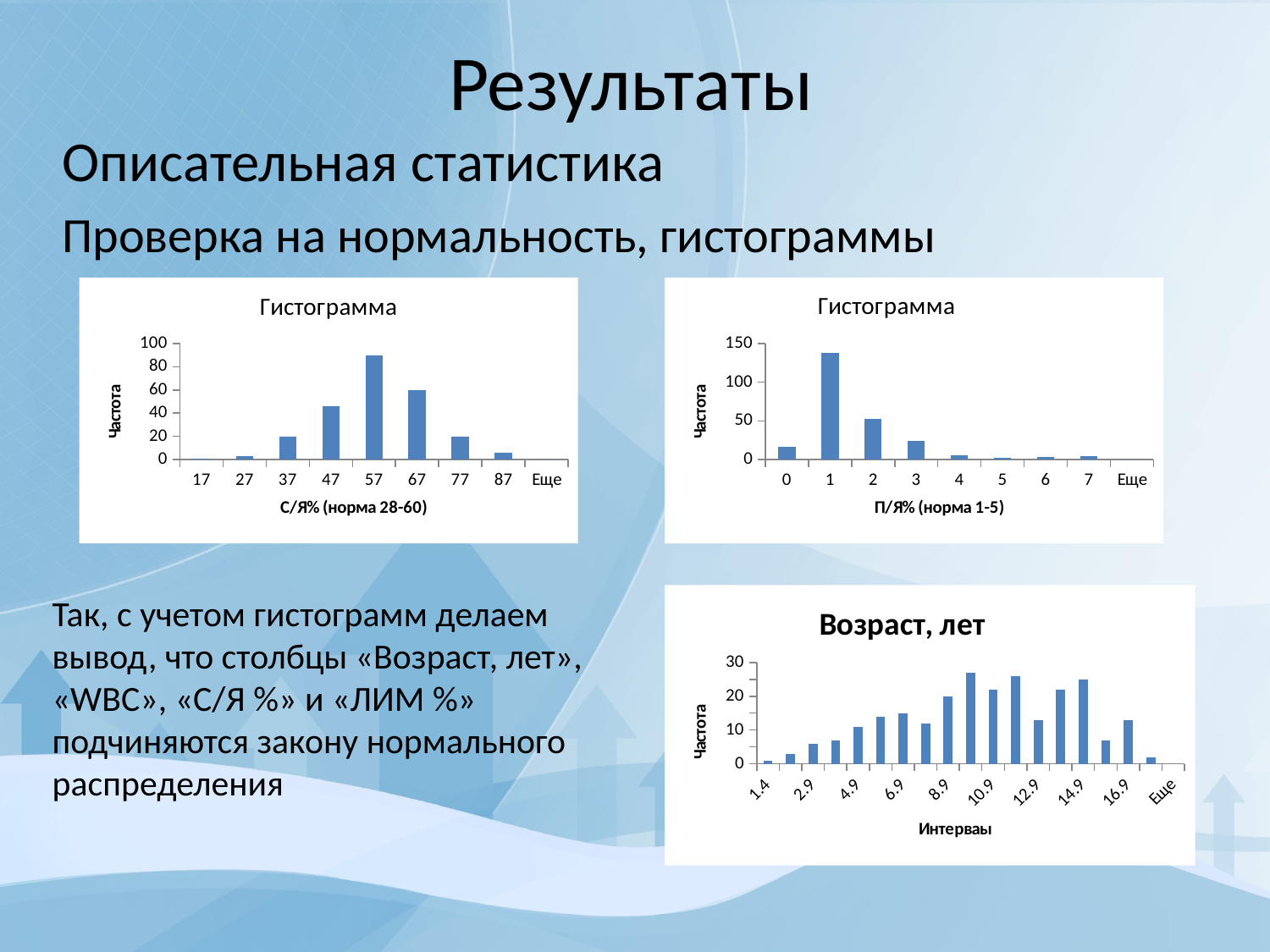
In the top-left chart (С/Я%), is the value for 47 greater or less than 60? less In the top-left chart (С/Я%), which is larger, the value for 47 or the value for 57? 57 In the top-left chart (С/Я%), is the value for 87 greater or less than 20? less In the top-right chart (П/Я%), which category has the highest bar? 1 In the top-right chart (П/Я%), is the value for 1 greater or less than 100? greater In the top-left chart (С/Я%), which category has the highest bar? 57 In the top-right chart (П/Я%), which is larger, the value for 1 or the value for 2? 1 What kind of chart is the bottom-right chart titled 'Возраст, лет'? bar chart How many categories are shown on the x axis of the top-left chart (С/Я%)? 9 What is the x-axis title of the bottom-right chart 'Возраст, лет'? Интерваы